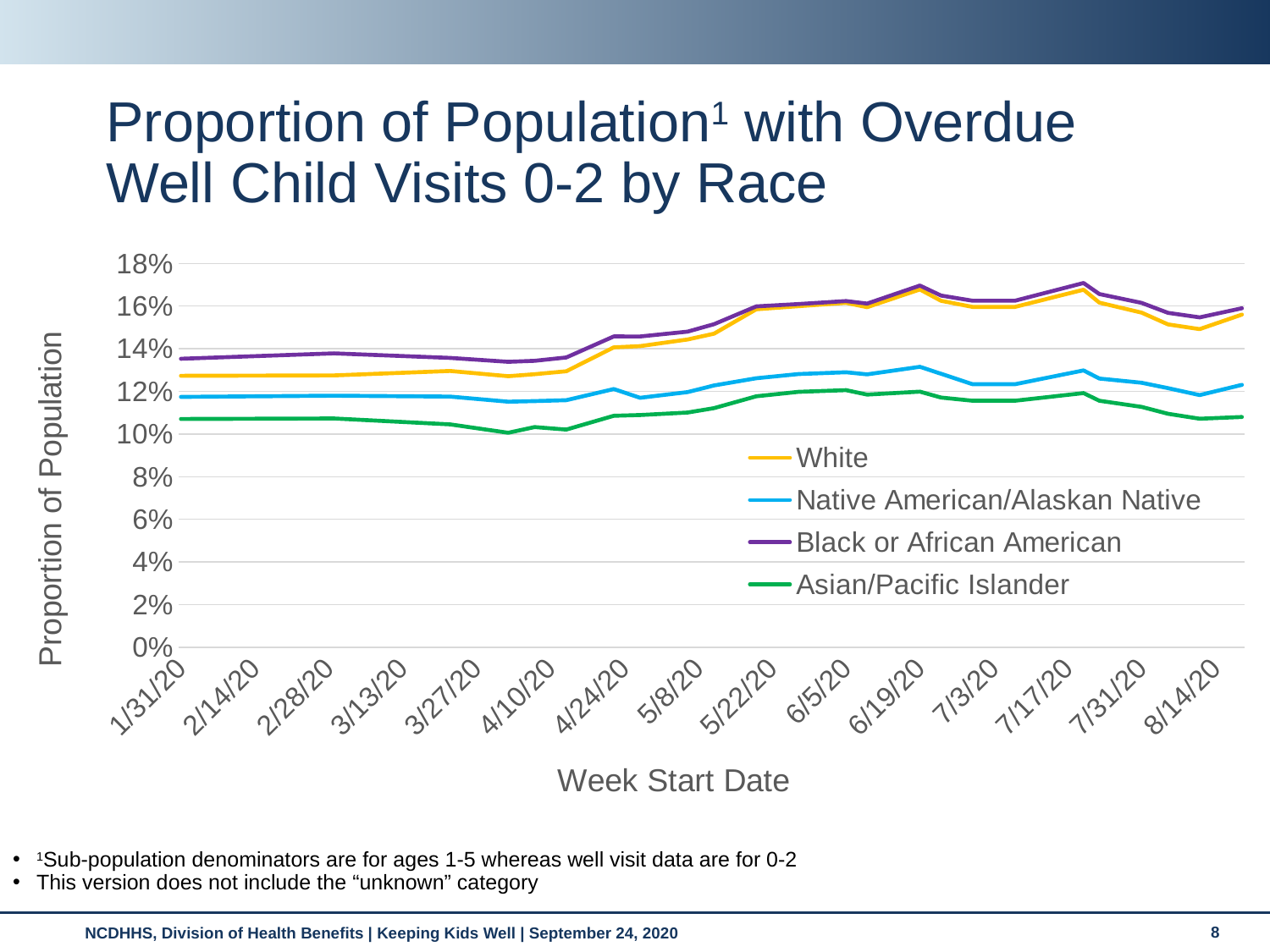
How many series does the legend list? 4 Is the value for Black or African American at 6/19/20 greater or less than 16%? greater At 8/14/20, which is larger: the value for Native American/Alaskan Native or for Asian/Pacific Islander? Native American/Alaskan Native Does the White series rise or fall from 1/31/20 to 6/19/20? rise What is the title of the y axis? Proportion of Population Which series has the highest values across the chart? Black or African American What kind of chart is shown on the slide? line chart Is the value for Black or African American at 1/31/20 greater or less than 14%? less Is the value for Native American/Alaskan Native at 4/10/20 greater or less than 12%? less What is the title of the x axis? Week Start Date Which series has the lowest values across the chart? Asian/Pacific Islander